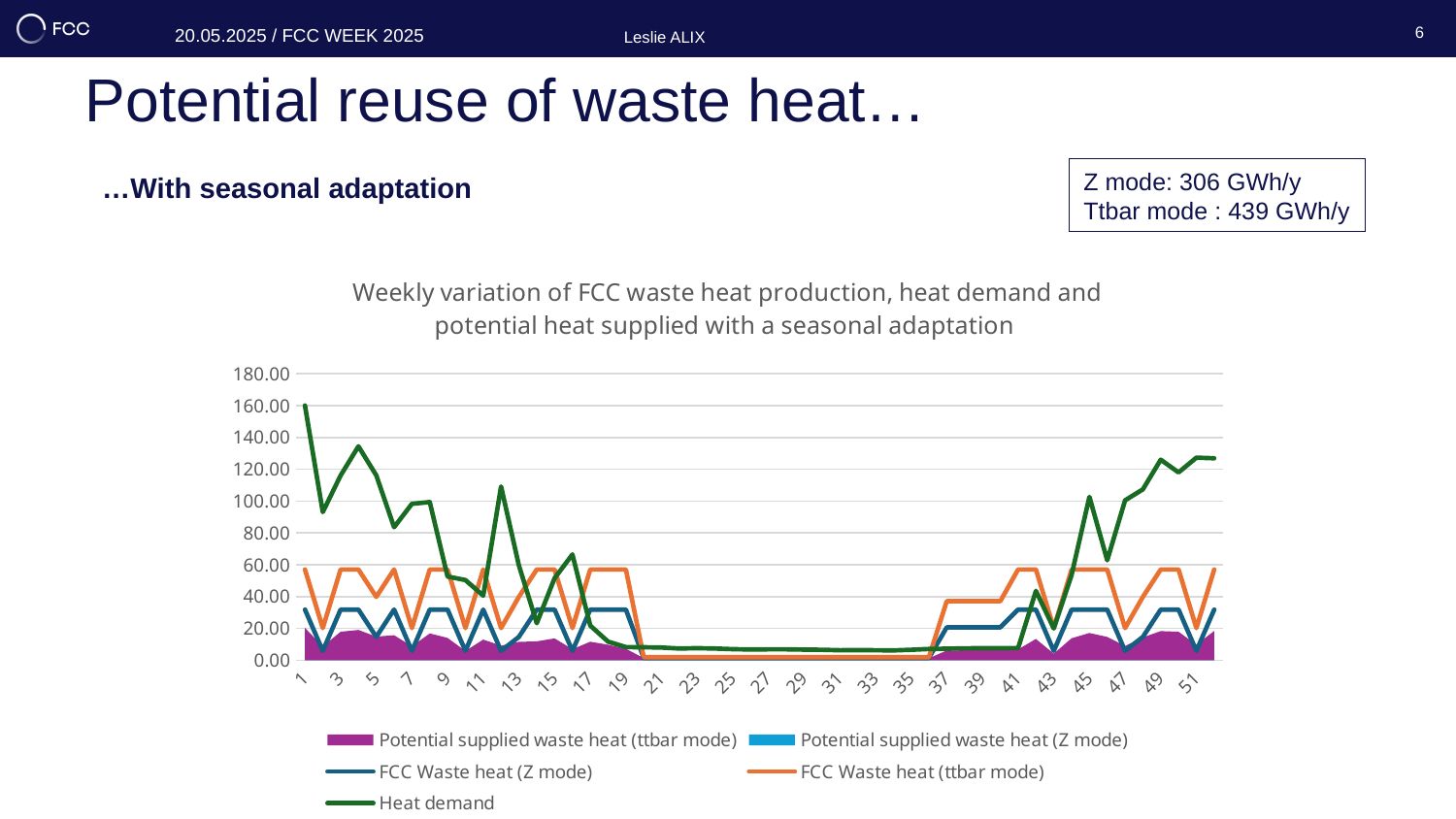
Is the Heat demand value at week 1 greater or less than 140? greater Does Heat demand generally rise or fall from week 37 to week 51? Rise Is the peak value of FCC Waste heat (ttbar mode) greater or less than 40? greater How many series does the chart legend list? 5 Does Heat demand generally rise or fall from week 1 to week 21? Fall At week 3, which is larger: FCC Waste heat (ttbar mode) or FCC Waste heat (Z mode)? FCC Waste heat (ttbar mode) What is the highest value shown on the vertical axis? 180.00 What is the title of the chart? Weekly variation of FCC waste heat production, heat demand and potential heat supplied with a seasonal adaptation Is the Heat demand value at week 51 greater or less than 120? greater Which series reaches the highest value on the chart? Heat demand What kind of chart is used to plot the Heat demand series? Line chart